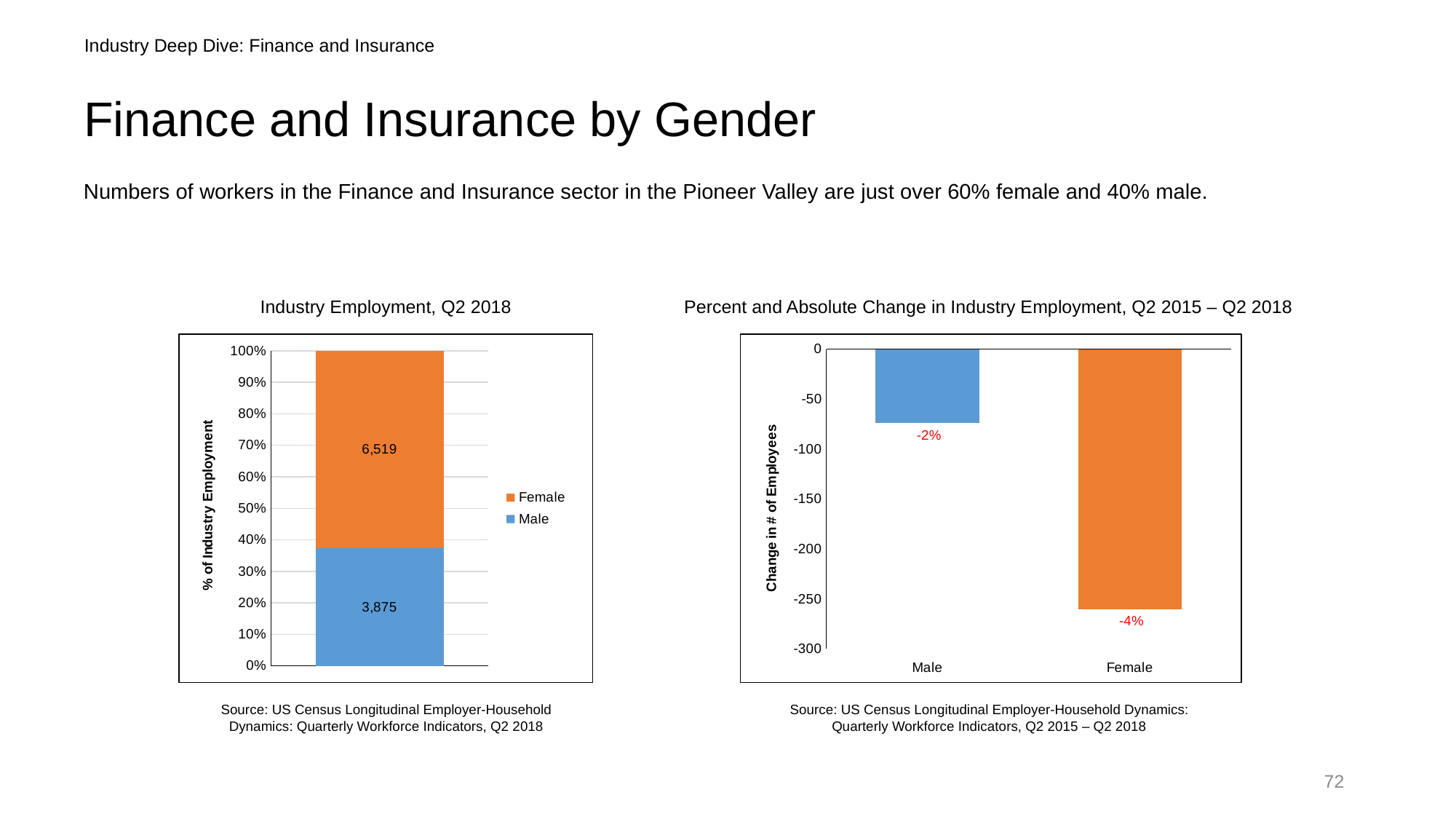
In the 'Industry Employment, Q2 2018' chart, what is the value shown for Male? 3,875 In the 'Percent and Absolute Change in Industry Employment, Q2 2015 – Q2 2018' chart, is the change in number of employees for Male greater or less than -100? greater In the 'Percent and Absolute Change in Industry Employment, Q2 2015 – Q2 2018' chart, what percent change is labelled for Female? -4% In the 'Industry Employment, Q2 2018' chart, what colour represents Male? Blue In the 'Industry Employment, Q2 2018' chart, what is the difference between the Female and Male values? 2,644 In the 'Industry Employment, Q2 2018' chart, which segment is larger, Female or Male? Female In the 'Industry Employment, Q2 2018' chart, what is the total of the two stacked segments? 10,394 What kind of chart is the 'Percent and Absolute Change in Industry Employment, Q2 2015 – Q2 2018' chart? Bar chart In the 'Industry Employment, Q2 2018' chart, how many series does the legend list? 2 In the 'Percent and Absolute Change in Industry Employment, Q2 2015 – Q2 2018' chart, is the change in number of employees for Female greater or less than -200? less In the 'Percent and Absolute Change in Industry Employment, Q2 2015 – Q2 2018' chart, what percent change is labelled for Male? -2% In the 'Industry Employment, Q2 2018' chart, what is the value shown for Female? 6,519